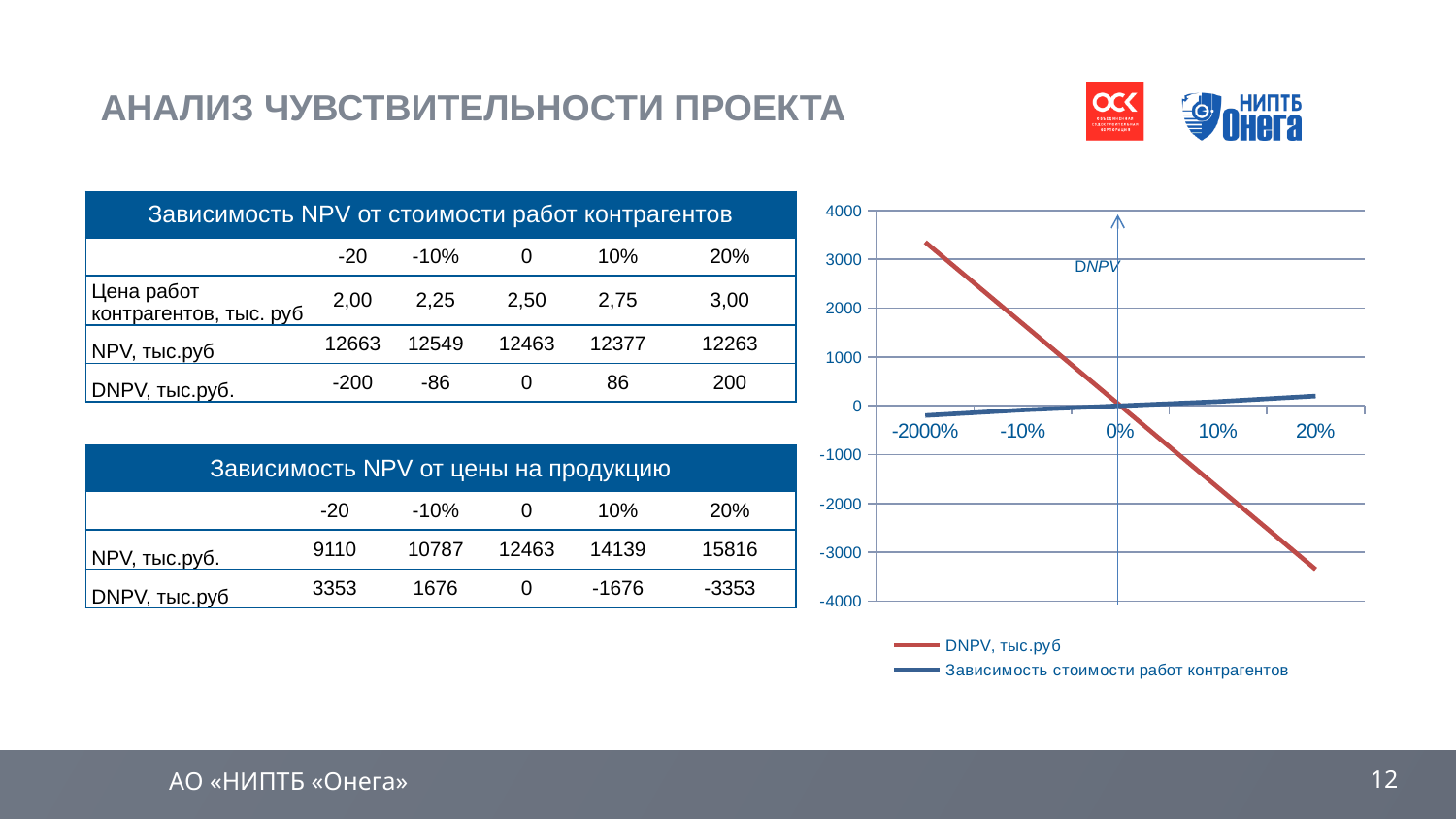
At 20%, which series has the higher value: 'DNPV, тыс.руб' or 'Зависимость стоимости работ контрагентов'? Зависимость стоимости работ контрагентов Is the value of the 'DNPV, тыс.руб' line at 10% greater or less than -1000? less Is the value of the 'DNPV, тыс.руб' line at -10% greater or less than 1000? greater How many x-axis tick labels are shown on the chart? 5 Is the value of the 'DNPV, тыс.руб' line at 20% greater or less than -3000? less What colour is the 'DNPV, тыс.руб' line in the chart? red Does the blue 'Зависимость стоимости работ контрагентов' line rise or fall as the x axis goes from left to right? rises What kind of chart is shown on the right of the slide? line chart Does the red 'DNPV, тыс.руб' line rise or fall as the x axis goes from left to right? falls What is the highest value shown on the chart's y axis? 4000 How many series does the chart legend list? 2 At the leftmost x-axis point, which series has the higher value: 'DNPV, тыс.руб' or 'Зависимость стоимости работ контрагентов'? DNPV, тыс.руб